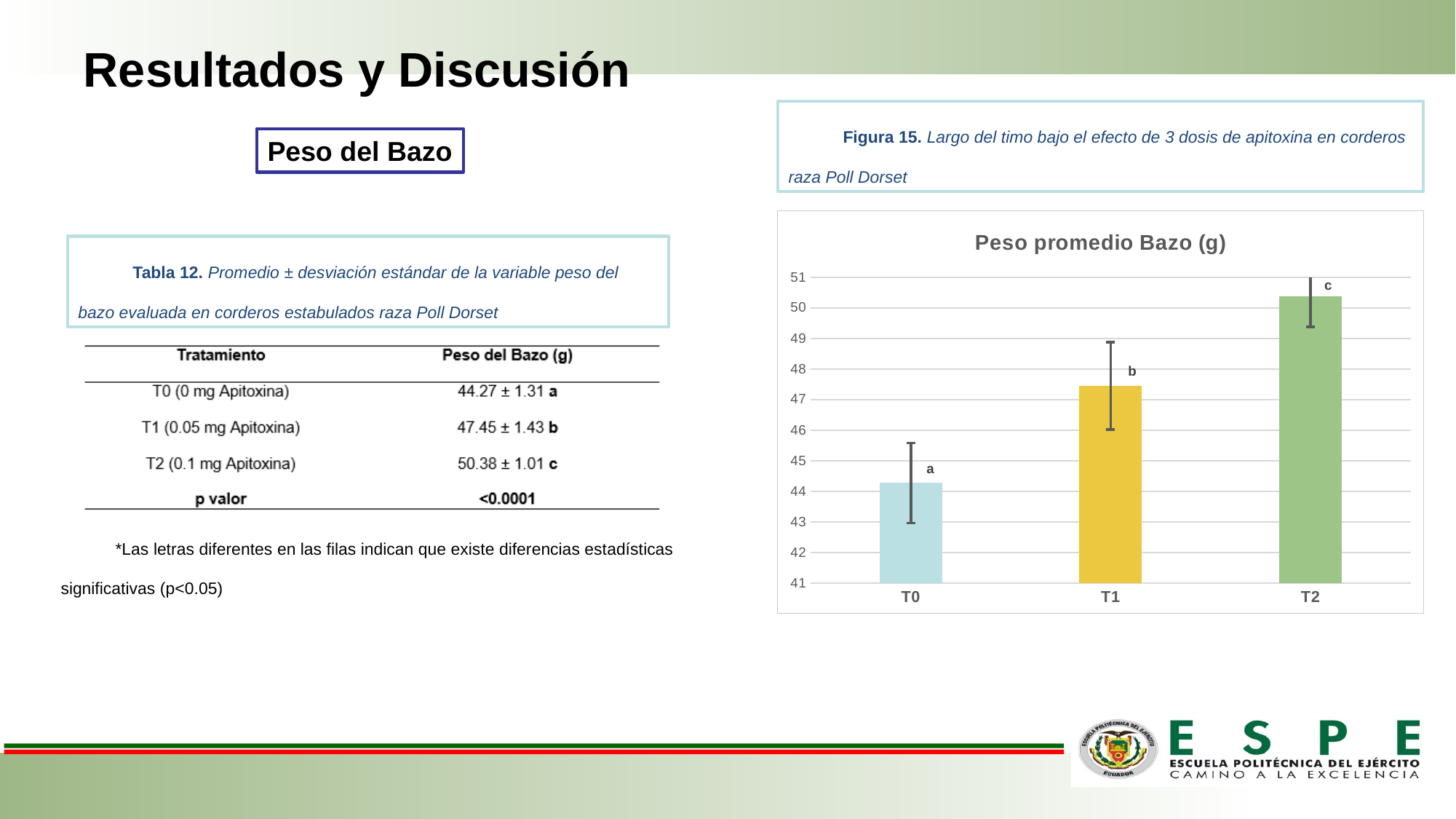
Is the value for T1 greater or less than 48? less Is the value for T1 greater or less than 46? greater What is the title of the chart? Peso promedio Bazo (g) Which treatment has the lowest bar in the chart? T0 Which bar is taller, T1 or T2? T2 Is the value for T2 greater or less than 50? greater How many treatment categories are plotted on the x axis of the chart? 3 What letter is printed above the T2 bar in the chart? c Which treatment has the highest bar in the chart? T2 Do the bar values rise or fall from T0 to T2 along the x axis? rise What kind of chart is shown under the title "Peso promedio Bazo (g)"? bar chart